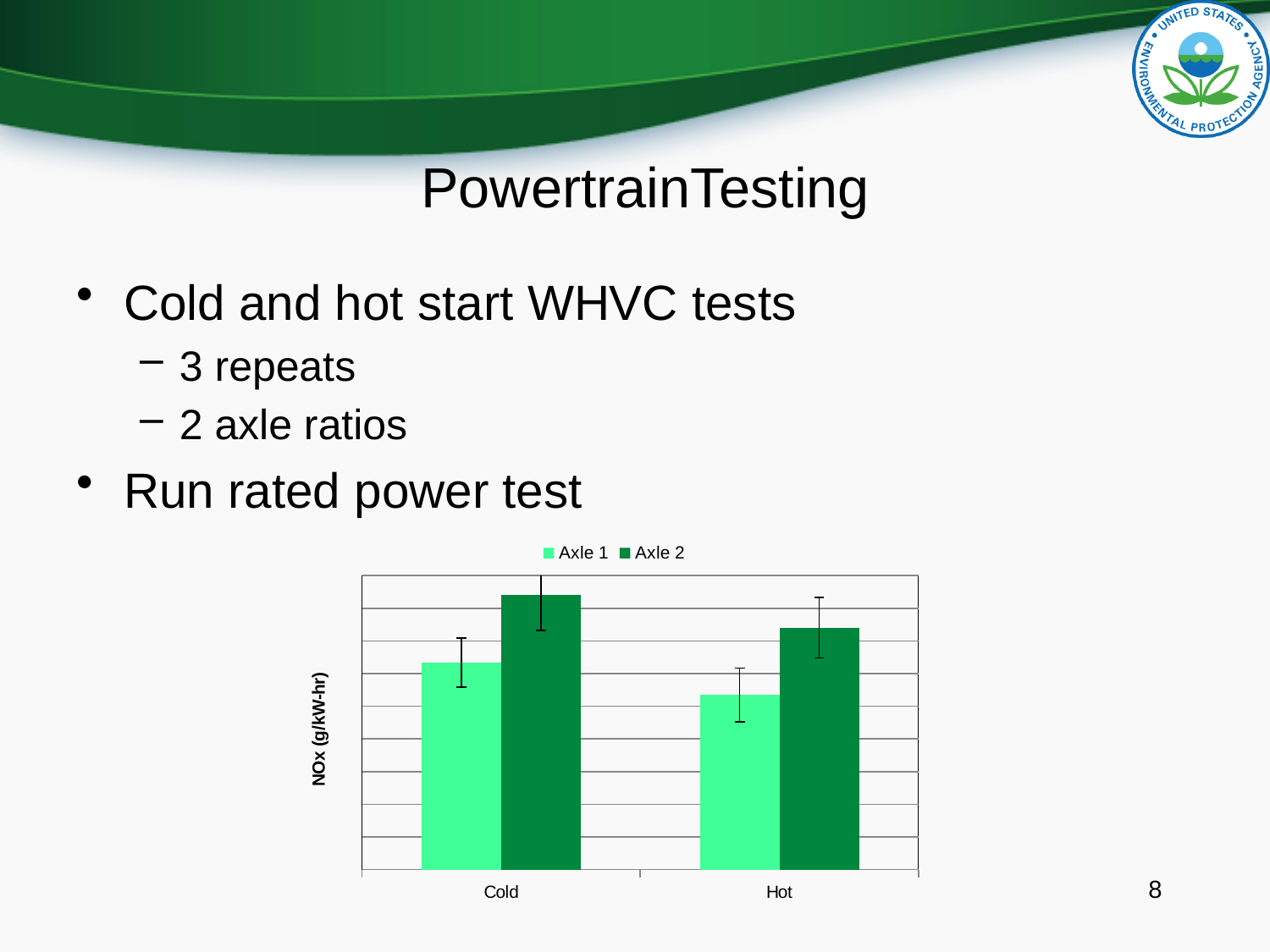
Which category has the lowest Axle 1 bar? Hot Is the Axle 1 value for Cold larger or smaller than the Axle 1 value for Hot? Larger Which bar is the shortest in the whole chart? Axle 1 for Hot How many categories are shown on the x axis of the chart? 2 For the Cold category, which series has the larger NOx value, Axle 1 or Axle 2? Axle 2 What are the two series named in the chart legend? Axle 1 and Axle 2 What kind of chart is shown on the slide? Bar chart Which bar is the tallest in the whole chart? Axle 2 for Cold Do the Axle 2 values rise or fall going from Cold to Hot? Fall What is the label of the chart's vertical axis? NOx (g/kW-hr) How many series does the chart legend list? 2 Which category has the highest Axle 2 bar? Cold